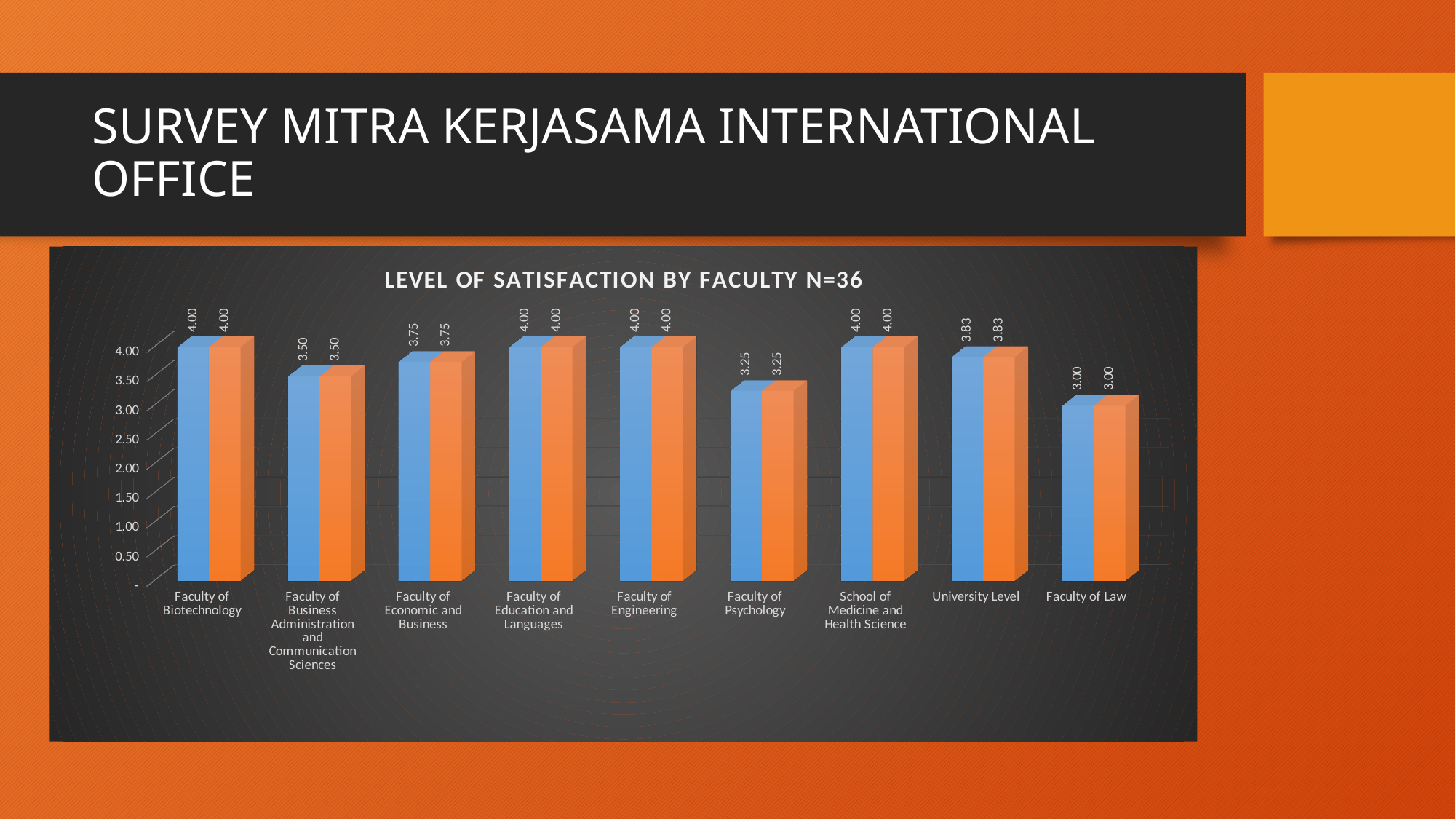
What is the level of satisfaction for University Level? 3.83 What is the difference between the satisfaction level of the Faculty of Engineering and the Faculty of Law? 1.00 How many faculties or categories are shown on the x axis of the chart? 9 What is the level of satisfaction for the Faculty of Economic and Business? 3.75 What is the level of satisfaction for the Faculty of Psychology? 3.25 Which category has the lowest level of satisfaction? Faculty of Law Is the value for the Faculty of Psychology greater or less than 3.50? less What kind of chart is shown on the slide? bar chart What is the title of the chart? LEVEL OF SATISFACTION BY FACULTY N=36 What is the difference between the satisfaction level of the School of Medicine and Health Science and the Faculty of Economic and Business? 0.25 What is the level of satisfaction for the Faculty of Business Administration and Communication Sciences? 3.50 Which has a higher level of satisfaction, the Faculty of Psychology or University Level? University Level